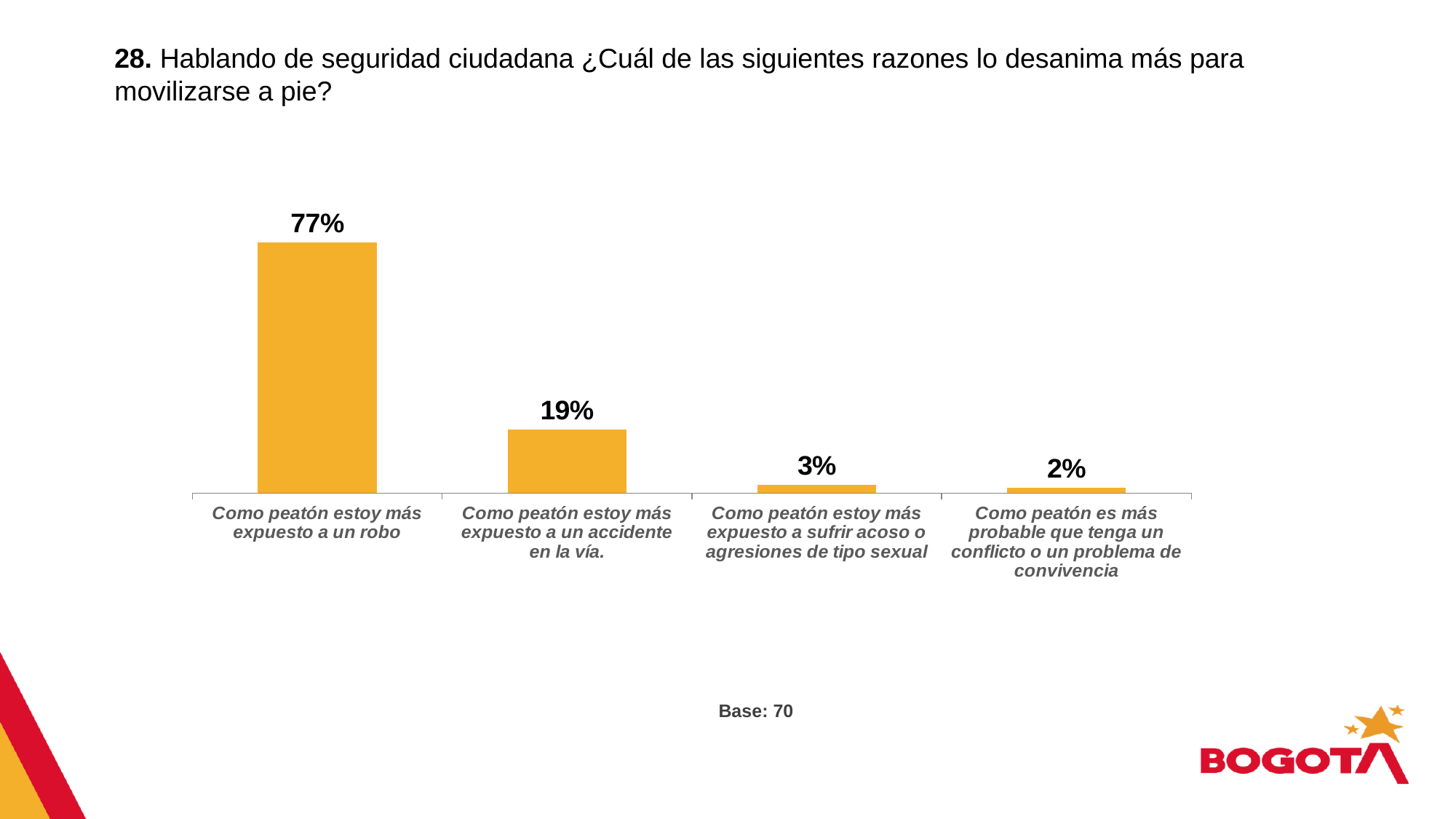
What kind of chart is shown on the slide? Bar chart Which is larger: the value for "expuesto a sufrir acoso o agresiones de tipo sexual" or the value for "conflicto o un problema de convivencia"? Como peatón estoy más expuesto a sufrir acoso o agresiones de tipo sexual What is the value for "Como peatón estoy más expuesto a sufrir acoso o agresiones de tipo sexual"? 3% Do the values rise or fall from left to right across the categories? Fall What is the difference between the value for "expuesto a un robo" and the value for "expuesto a un accidente en la vía"? 58% What is the base (number of respondents) stated below the chart? 70 How many categories are shown in the chart? 4 What is the value for "Como peatón estoy más expuesto a un accidente en la vía."? 19% Which reason has the lowest percentage? Como peatón es más probable que tenga un conflicto o un problema de convivencia What percentage of respondents chose "Como peatón estoy más expuesto a un robo"? 77% Which reason has the highest percentage? Como peatón estoy más expuesto a un robo What is the value for "Como peatón es más probable que tenga un conflicto o un problema de convivencia"? 2%